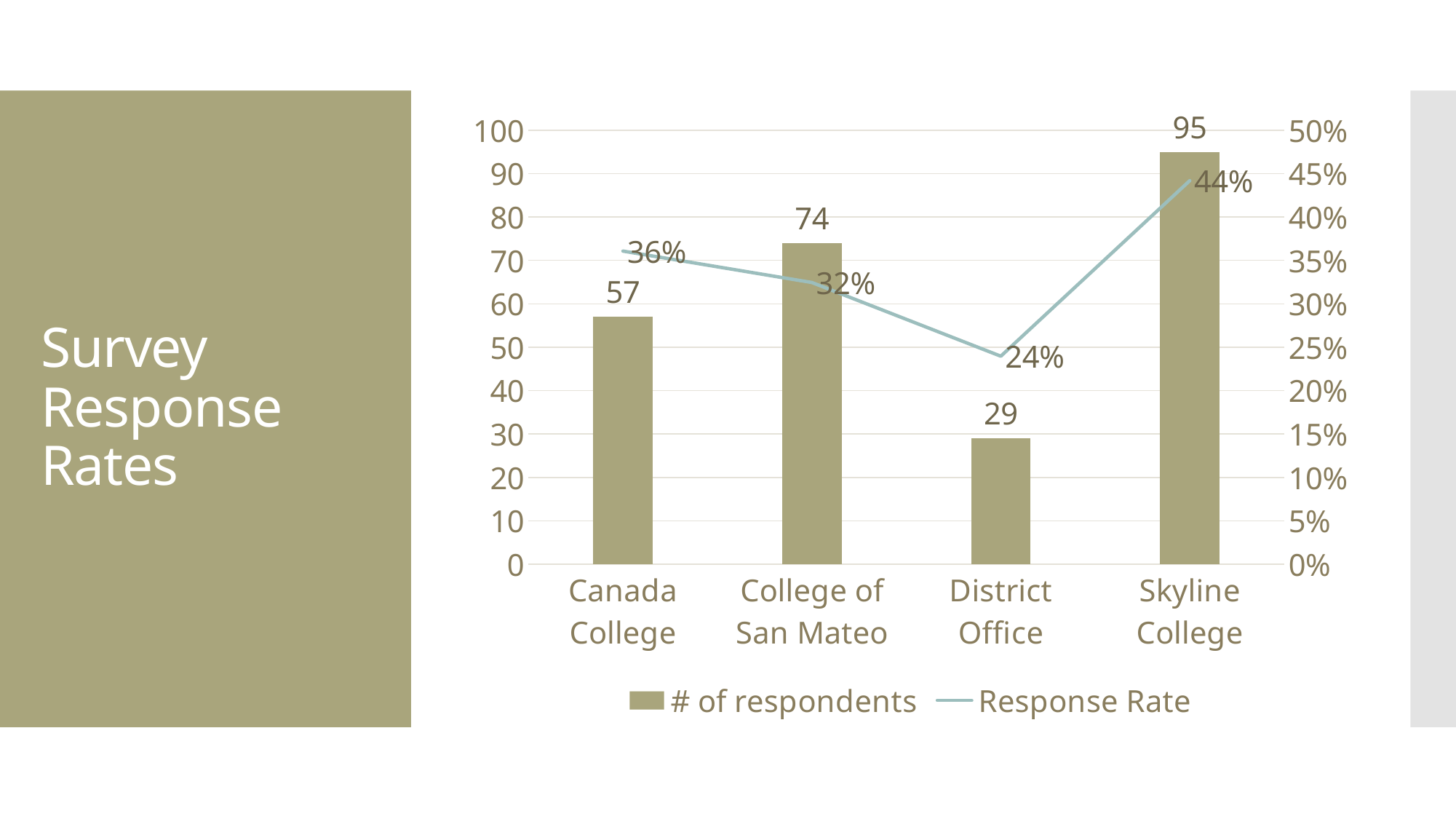
What is the response rate for District Office? 24% How many respondents did Skyline College have? 95 What is the difference in number of respondents between Skyline College and District Office? 66 How many respondents did College of San Mateo have? 74 How many series does the legend list? 2 Which category has the highest number of respondents? Skyline College Which has a higher response rate, Canada College or College of San Mateo? Canada College What is the response rate for Canada College? 36% What is the title of the slide? Survey Response Rates Does the response rate rise or fall from Canada College to District Office? fall Which category has the lowest response rate? District Office How many categories are shown on the x axis? 4